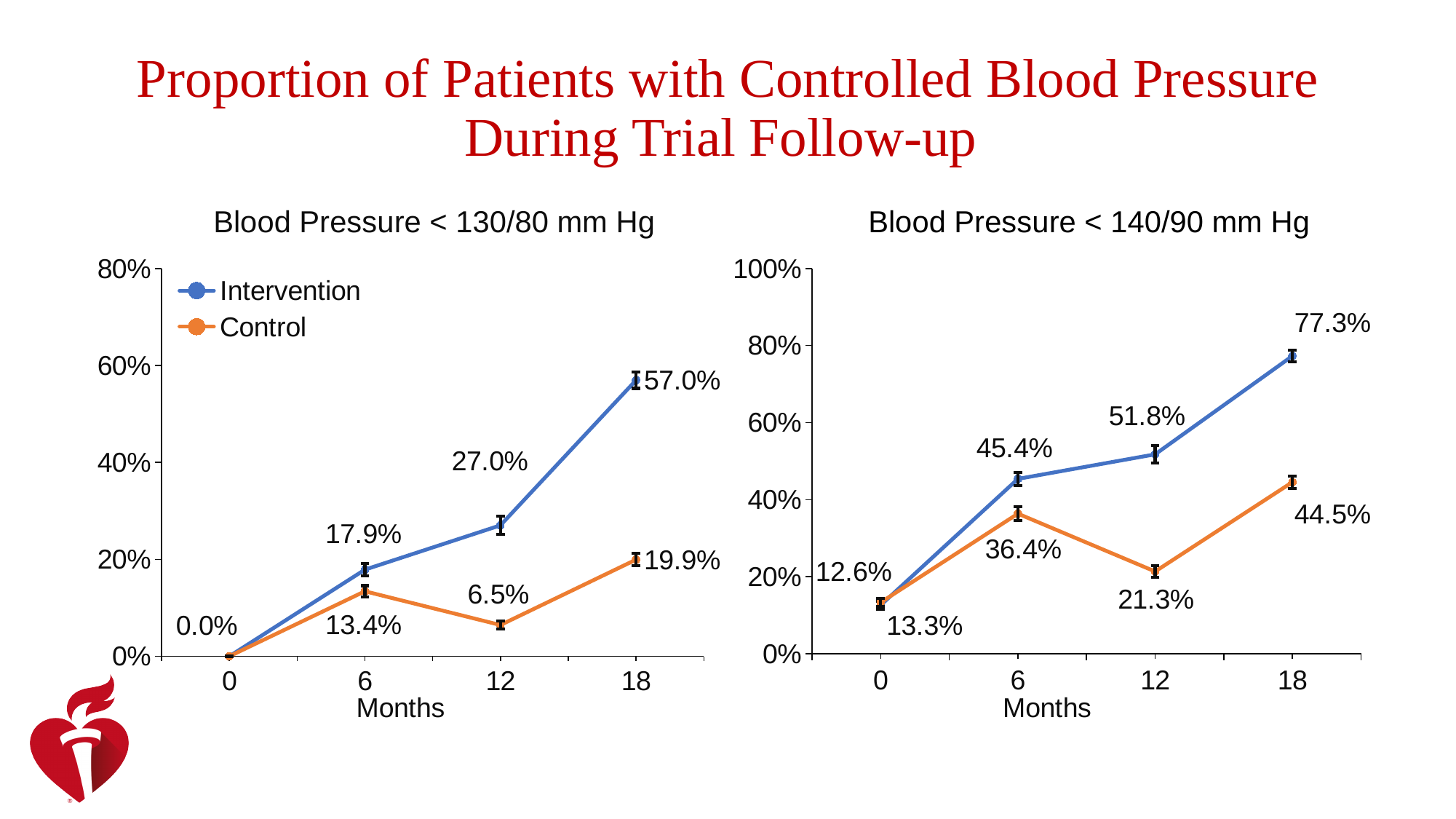
In the 'Blood Pressure < 140/90 mm Hg' chart, what is the Intervention value at 6 months? 45.4% In the 'Blood Pressure < 130/80 mm Hg' chart, which series has the higher value at 6 months, Intervention or Control? Intervention In the 'Blood Pressure < 130/80 mm Hg' chart, what is the Control value at 12 months? 6.5% What kind of chart is the 'Blood Pressure < 140/90 mm Hg' chart? Line chart In the 'Blood Pressure < 130/80 mm Hg' chart, what is the difference between the Intervention and Control values at 18 months? 37.1% In the 'Blood Pressure < 130/80 mm Hg' chart, what is the Intervention value at 18 months? 57.0% In the 'Blood Pressure < 140/90 mm Hg' chart, what is the Control value at 18 months? 44.5% In the 'Blood Pressure < 140/90 mm Hg' chart, at which month does the Intervention series reach its highest value? 18 In the 'Blood Pressure < 140/90 mm Hg' chart, what is the difference between the Intervention values at 18 months and 12 months? 25.5% How many series does the legend list on the slide? 2 In the 'Blood Pressure < 130/80 mm Hg' chart, at which month is the Control value lowest? 0 In the 'Blood Pressure < 130/80 mm Hg' chart, does the Intervention series rise or fall from 0 to 18 months? Rise